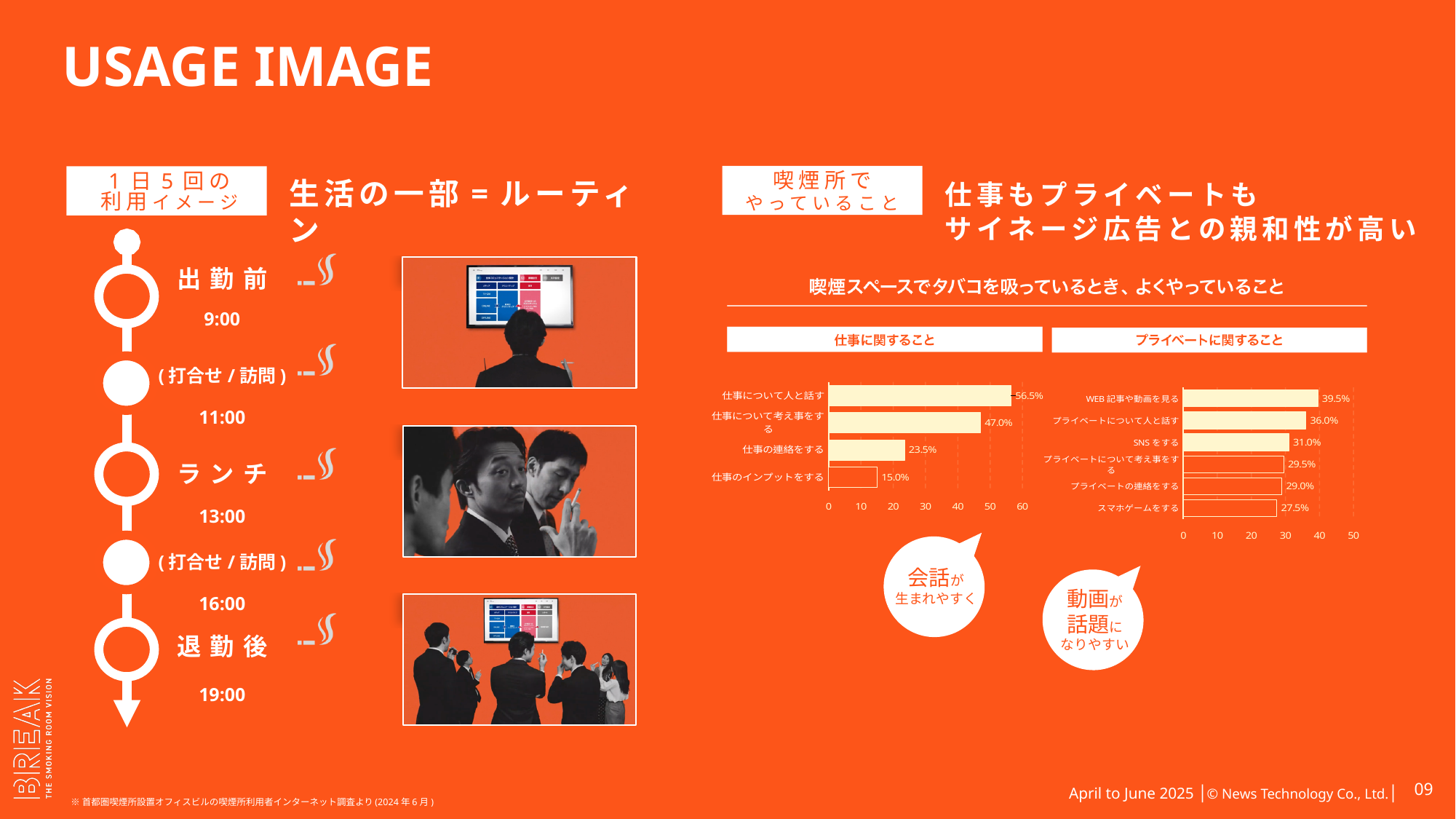
In the プライベートに関すること chart, which category has the lowest value? スマホゲームをする In the 仕事に関すること chart, what is the value for 仕事について人と話す? 56.5% In the 仕事に関すること chart, which category has the highest value? 仕事について人と話す In the プライベートに関すること chart, which category has the highest value? WEB記事や動画を見る In the 仕事に関すること chart, which is larger: 仕事の連絡をする or 仕事のインプットをする? 仕事の連絡をする In the プライベートに関すること chart, what is the value for スマホゲームをする? 27.5% How many categories are shown in the プライベートに関すること chart? 6 In the 仕事に関すること chart, what is the value for 仕事のインプットをする? 15.0% In the プライベートに関すること chart, what is the value for SNSをする? 31.0% In the 仕事に関すること chart, what is the difference between 仕事について人と話す and 仕事について考え事をする? 9.5% In the プライベートに関すること chart, what is the difference between WEB記事や動画を見る and プライベートについて人と話す? 3.5% What kind of chart is the 仕事に関すること chart? Bar chart